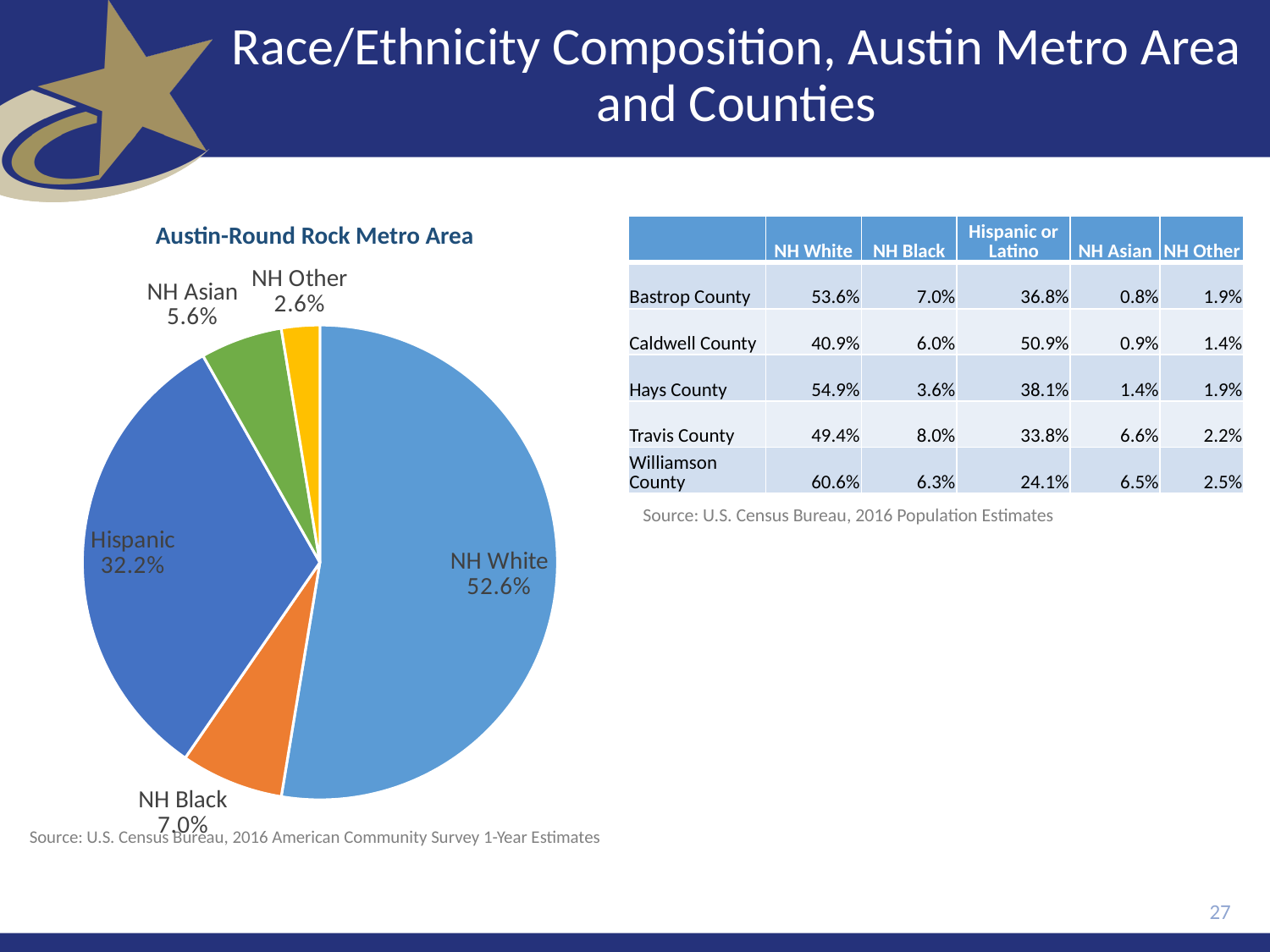
What share of the pie chart is NH Black? 7.0% What share of the pie chart is NH White? 52.6% What type of chart is shown on the slide? Pie chart Which slice of the pie chart is the smallest? NH Other What share of the pie chart is Hispanic? 32.2% What is the difference in percentage points between the NH White and Hispanic slices of the pie chart? 20.4 What share of the pie chart is NH Other? 2.6% How many slices does the pie chart have? 5 Which slice of the pie chart is the largest? NH White What share of the pie chart is NH Asian? 5.6% What is the title of the pie chart? Austin-Round Rock Metro Area Which slice of the pie chart is larger, NH Black or NH Asian? NH Black